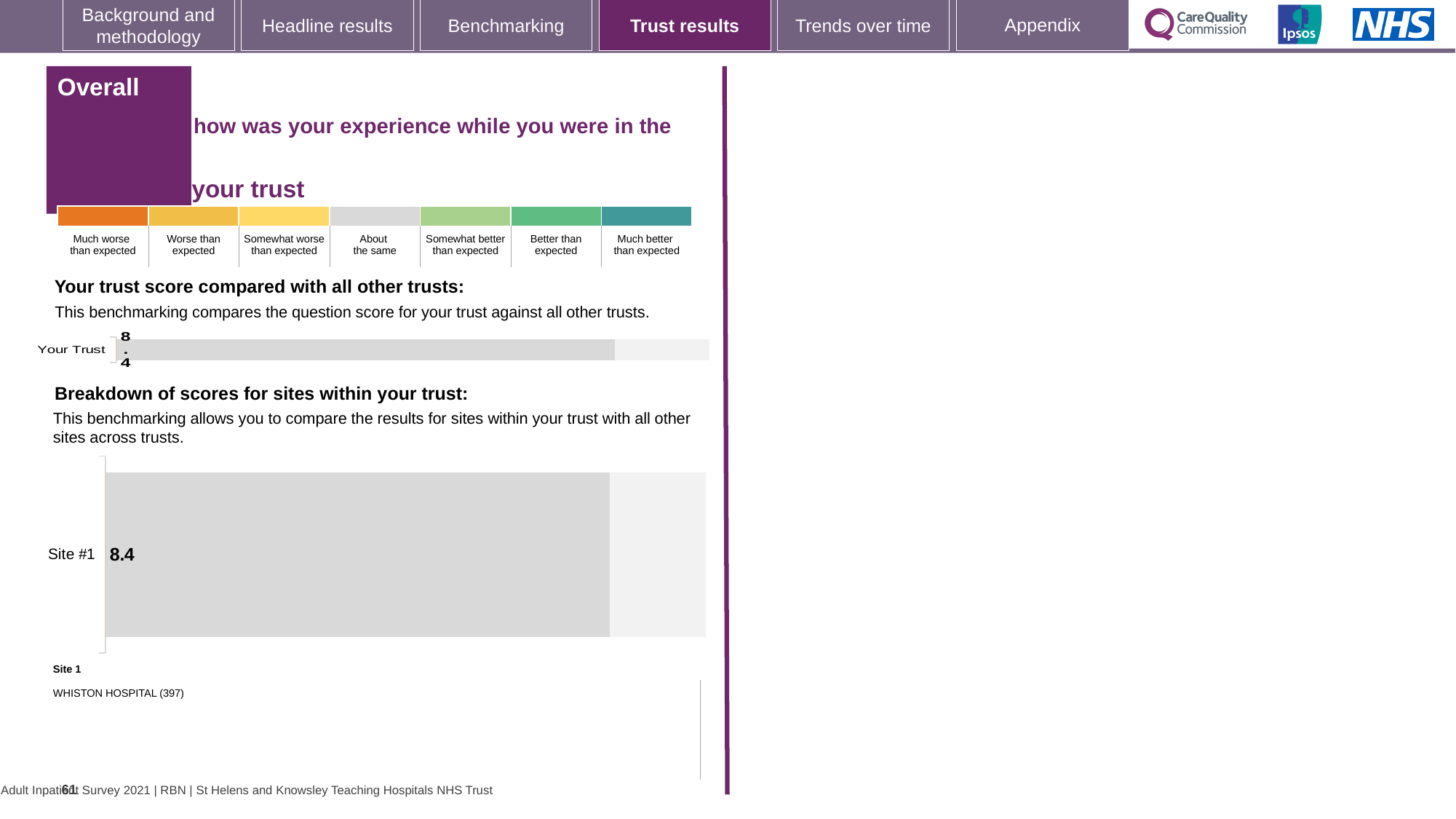
What kind of chart is the 'Breakdown of scores for sites within your trust' chart? bar chart What kind of chart is the 'Your trust score compared with all other trusts' chart? bar chart In the 'Your trust score compared with all other trusts' chart, what is the score for Your Trust? 8.4 In the 'Breakdown of scores for sites within your trust' chart, which hospital is listed as Site 1? WHISTON HOSPITAL (397) How many categories are plotted in the 'Your trust score compared with all other trusts' chart? 1 In the 'Breakdown of scores for sites within your trust' chart, what is the score for Site #1? 8.4 How many rating categories are shown in the colour key above the charts, from 'Much worse than expected' to 'Much better than expected'? 7 How many sites are plotted in the 'Breakdown of scores for sites within your trust' chart? 1 What is the difference between the Your Trust score in the trust chart and the Site #1 score in the sites chart? 0